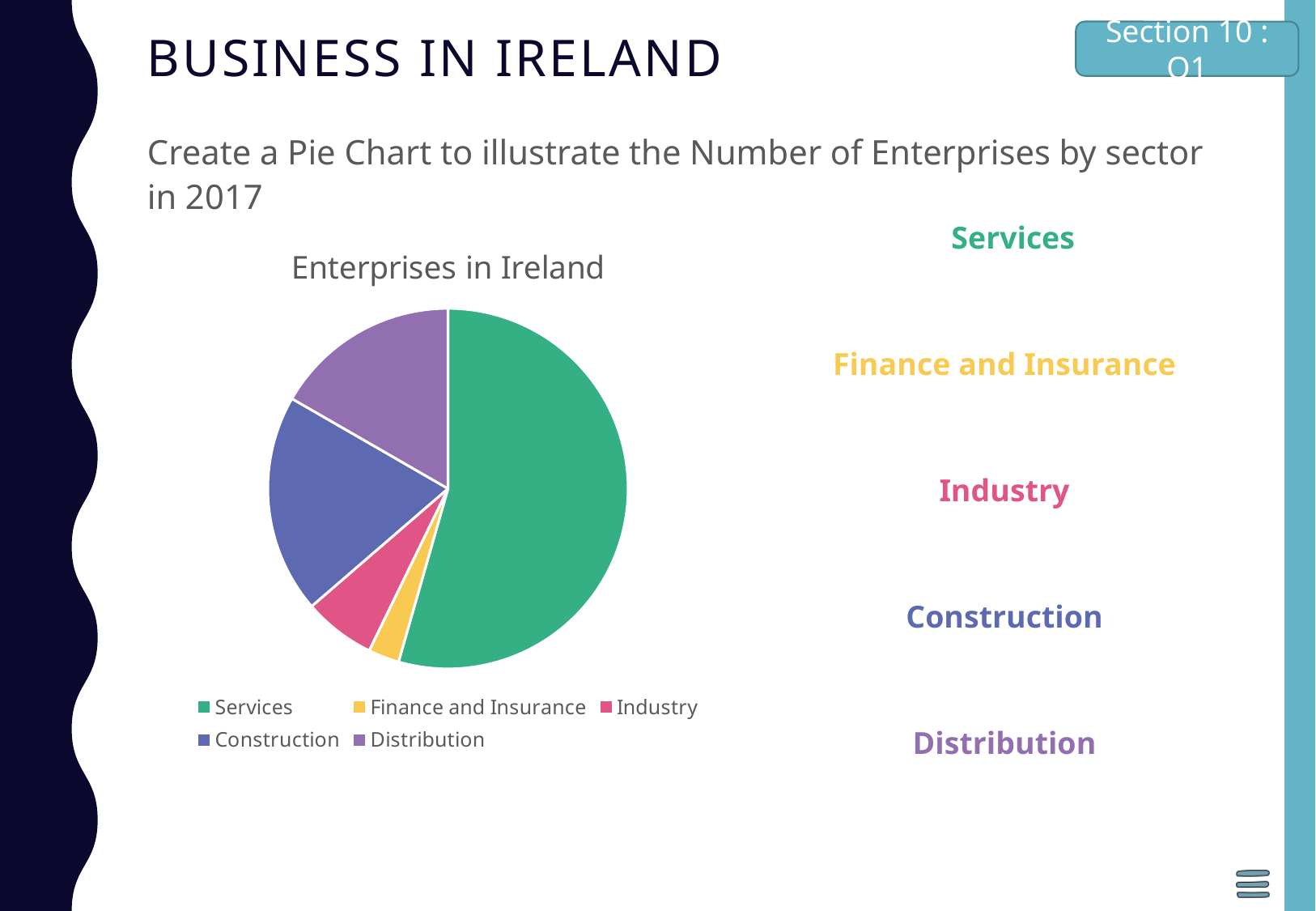
What kind of chart is shown on the slide? Pie chart Which slice is larger, Services or Construction? Services How many entries does the chart legend list? 5 Which slice is larger, Industry or Finance and Insurance? Industry Which sector has the smallest slice of the pie chart? Finance and Insurance How many sectors (slices) does the pie chart show? 5 Which sector has the largest slice of the pie chart? Services Which slice is larger, Construction or Distribution? Construction Which sector is shown in purple on the pie chart? Distribution What is the title of the chart? Enterprises in Ireland